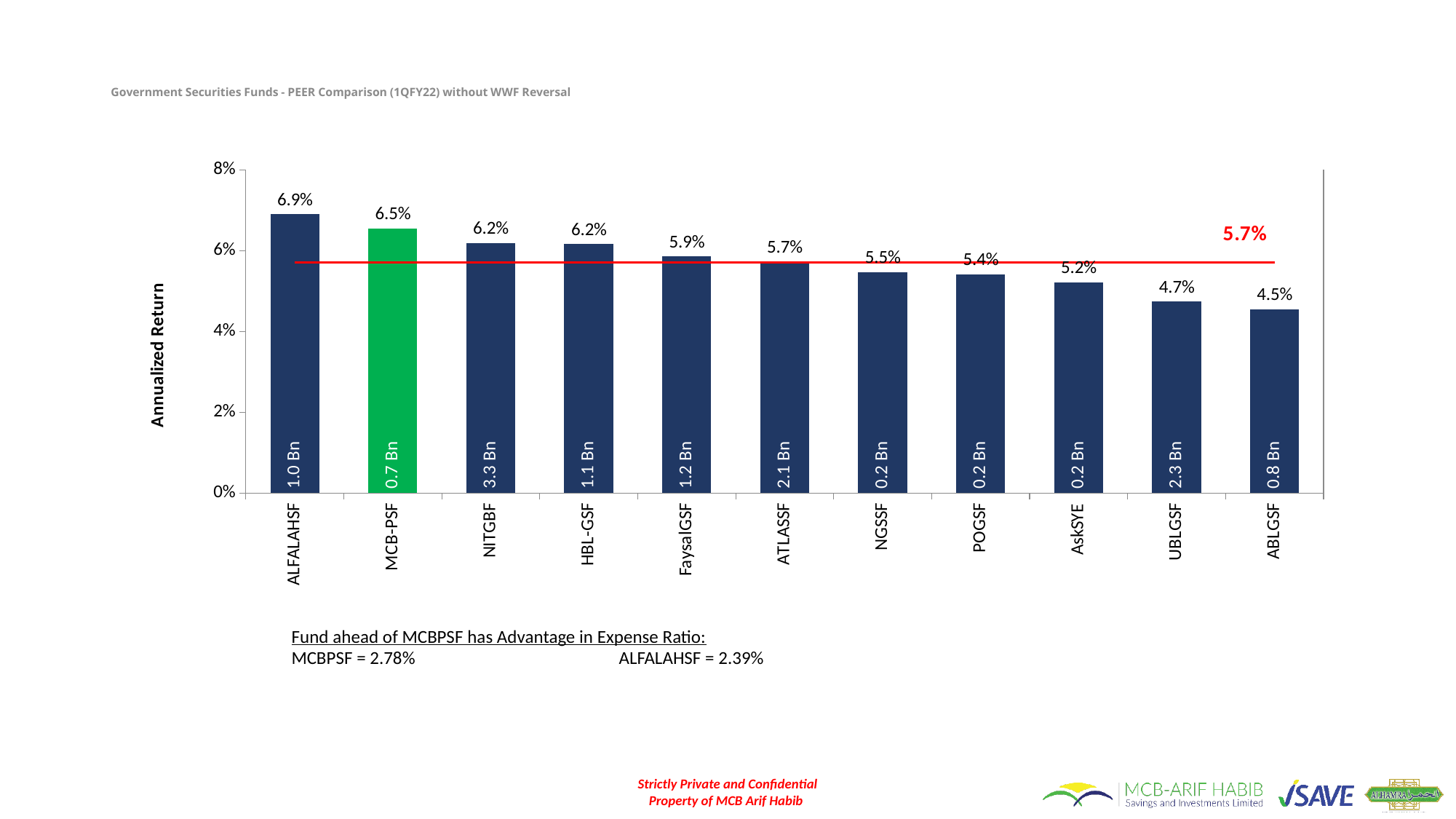
What is the annualized return for MCB-PSF? 6.5% Which fund has the lowest annualized return? ABLGSF What value is marked by the red horizontal line on the chart? 5.7% What is the annualized return for ALFALAHSF? 6.9% Which has a higher annualized return, FaysalGSF or NGSSF? FaysalGSF What is the annualized return for UBLGSF? 4.7% What type of chart is shown on the slide? bar chart Which fund has the highest annualized return? ALFALAHSF How many funds are shown in the chart? 11 Is the annualized return for ABLGSF greater or less than 6%? less Do the annualized returns rise or fall from left to right across the funds? fall What is the difference in annualized return between ALFALAHSF and MCB-PSF? 0.4%